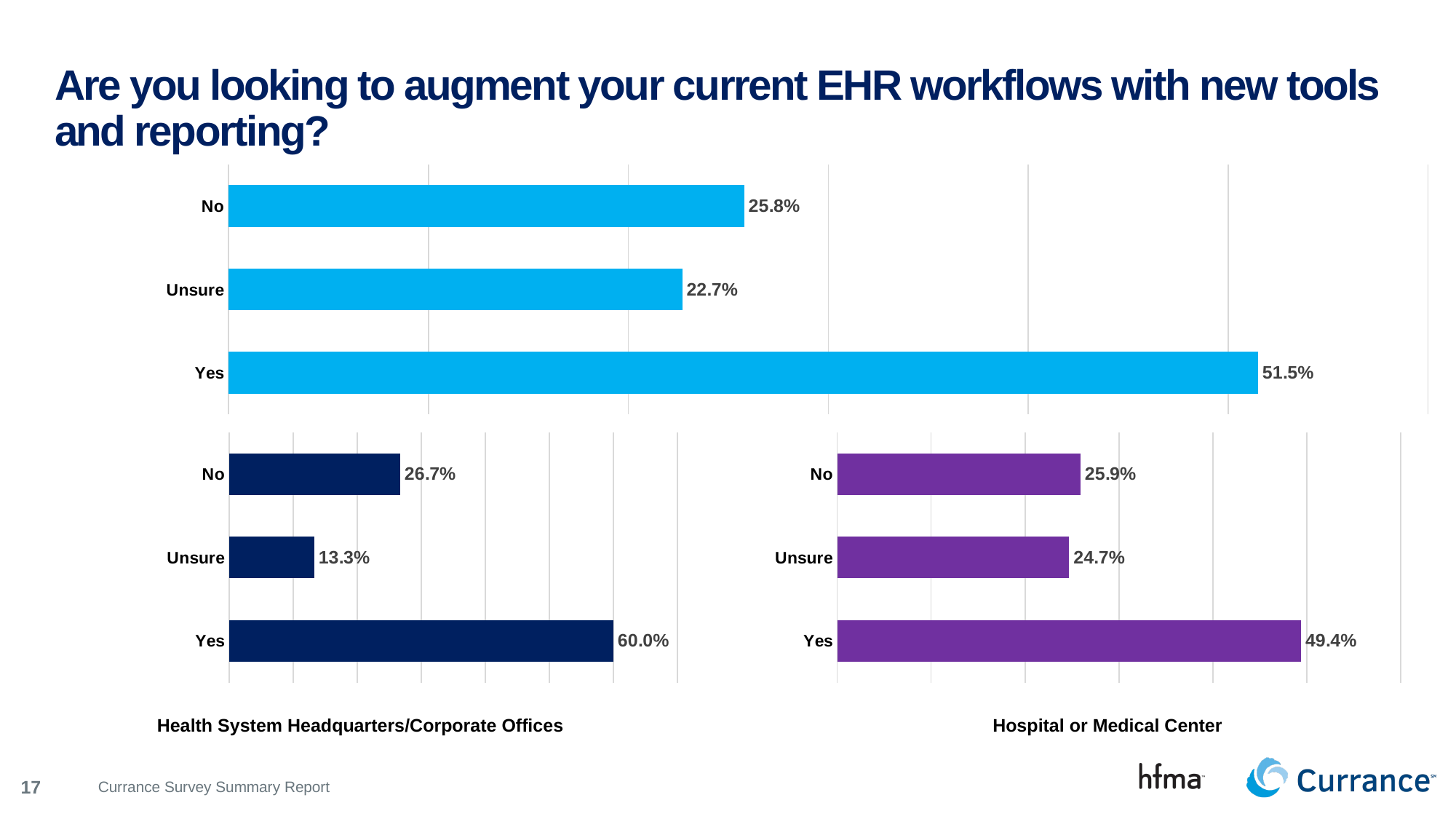
In the top chart, what is the difference between the values for No and Unsure? 3.1% In the top chart, what is the value for Yes? 51.5% How many charts are shown on the slide? 3 In the Health System Headquarters/Corporate Offices chart, what is the difference between the values for Yes and No? 33.3% In the Hospital or Medical Center chart, which category has the highest value? Yes In the Health System Headquarters/Corporate Offices chart, what is the value for Yes? 60.0% How many categories are shown in the Hospital or Medical Center chart? 3 In the top chart, what is the value for Unsure? 22.7% Which is larger: the value for Yes in the Health System Headquarters/Corporate Offices chart or the value for Yes in the Hospital or Medical Center chart? Health System Headquarters/Corporate Offices In the Health System Headquarters/Corporate Offices chart, which category has the lowest value? Unsure What kind of chart is the top chart? Bar chart In the Hospital or Medical Center chart, what is the value for Unsure? 24.7%